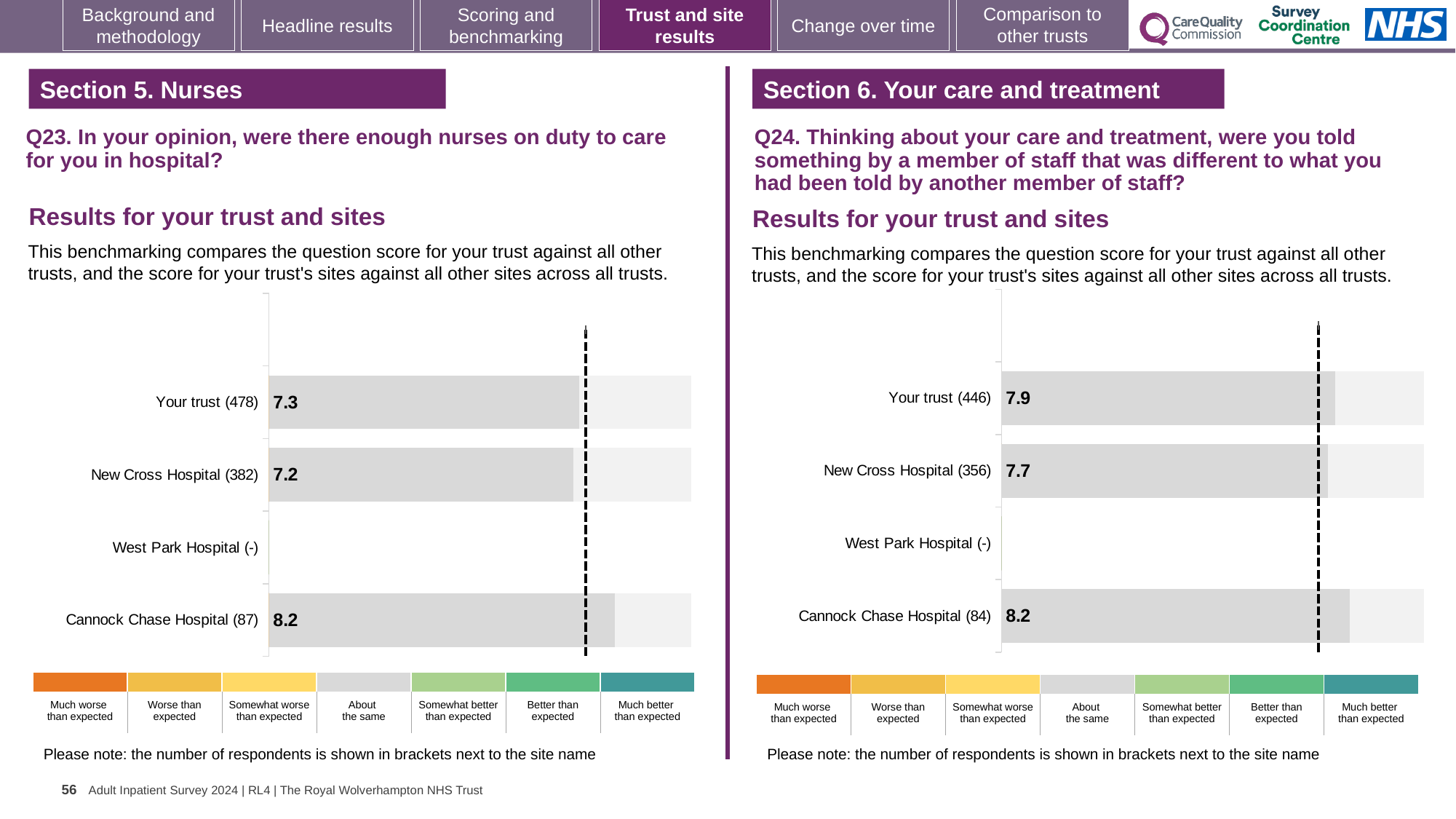
On the Q24 chart (right), what is the difference between the Your trust score and the New Cross Hospital score? 0.2 On the Q23 chart (left), which site or trust has the highest score? Cannock Chase Hospital What type of chart is used on the Q23 chart (left)? Bar chart How many site or trust categories are listed on the Q24 chart (right)? 4 On the Q23 chart (left), which is larger: the score for Your trust or the score for New Cross Hospital? Your trust On the Q24 chart (right), which site or trust has the lowest printed score? New Cross Hospital On the Q23 chart (left), what is the score for Your trust? 7.3 On the Q24 chart (right), what is the score for Your trust? 7.9 How many respondents are shown in brackets for Your trust on the Q24 chart (right)? 446 On the Q23 chart (left), what is the difference between the Cannock Chase Hospital score and the New Cross Hospital score? 1.0 On the Q23 chart (left), what is the score for Cannock Chase Hospital? 8.2 On the Q24 chart (right), what is the score for New Cross Hospital? 7.7